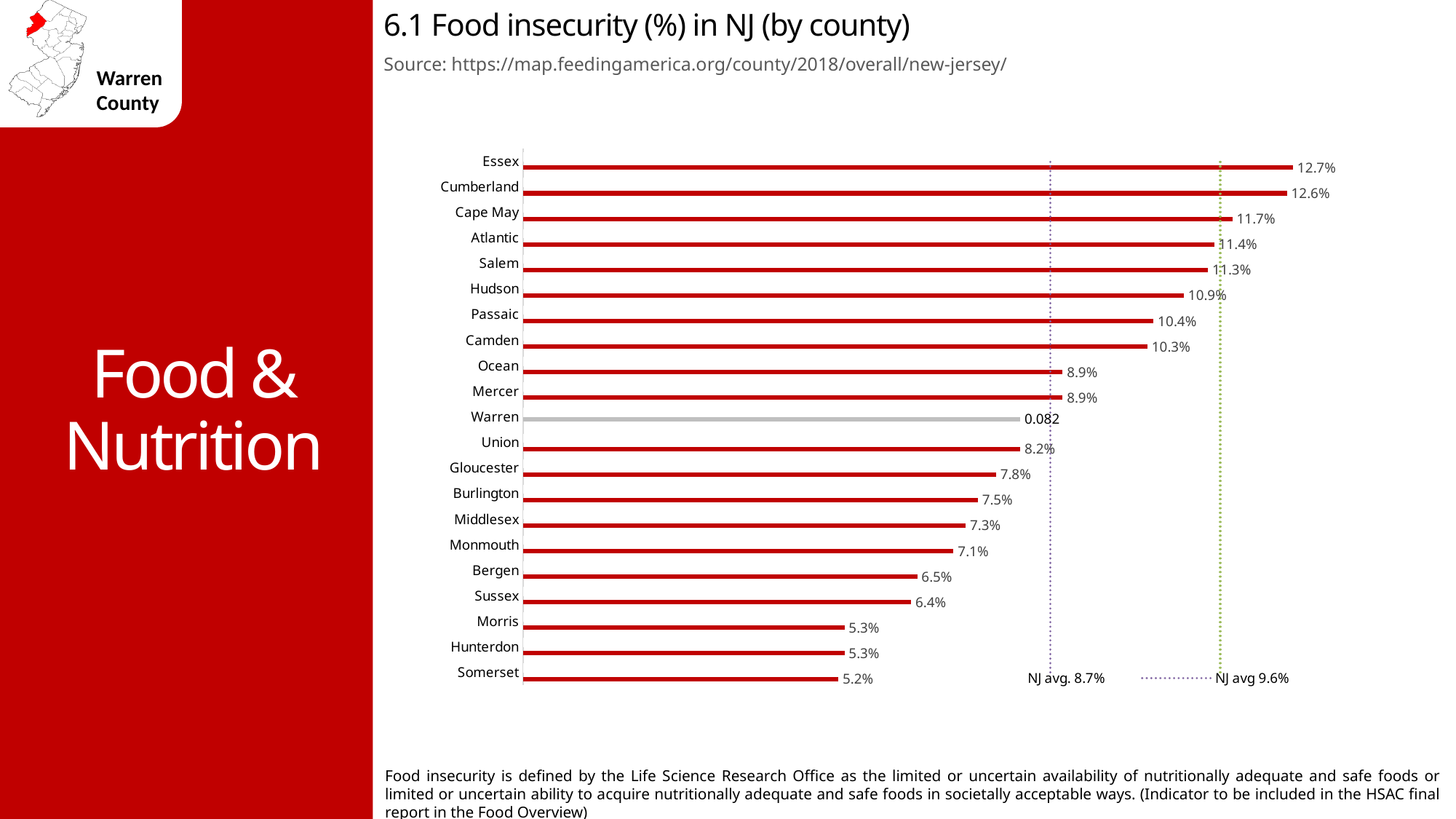
How many counties are shown in the chart? 21 What two NJ average reference values are marked by the dotted lines on the chart? NJ avg. 8.7% and NJ avg 9.6% What is the food insecurity value shown for Essex? 12.7% What is the difference between the values for Cape May and Atlantic? 0.3 percentage points What is the value shown for Hudson? 10.9% Which county has the lowest food insecurity value? Somerset Do the values rise or fall going from the top bar (Essex) to the bottom bar (Somerset)? fall What value is printed next to the Warren bar? 0.082 What type of chart is shown on the slide? bar chart Which has a higher value, Hudson or Passaic? Hudson Which county has the highest food insecurity value? Essex What is the difference between the values for Essex and Somerset? 7.5 percentage points